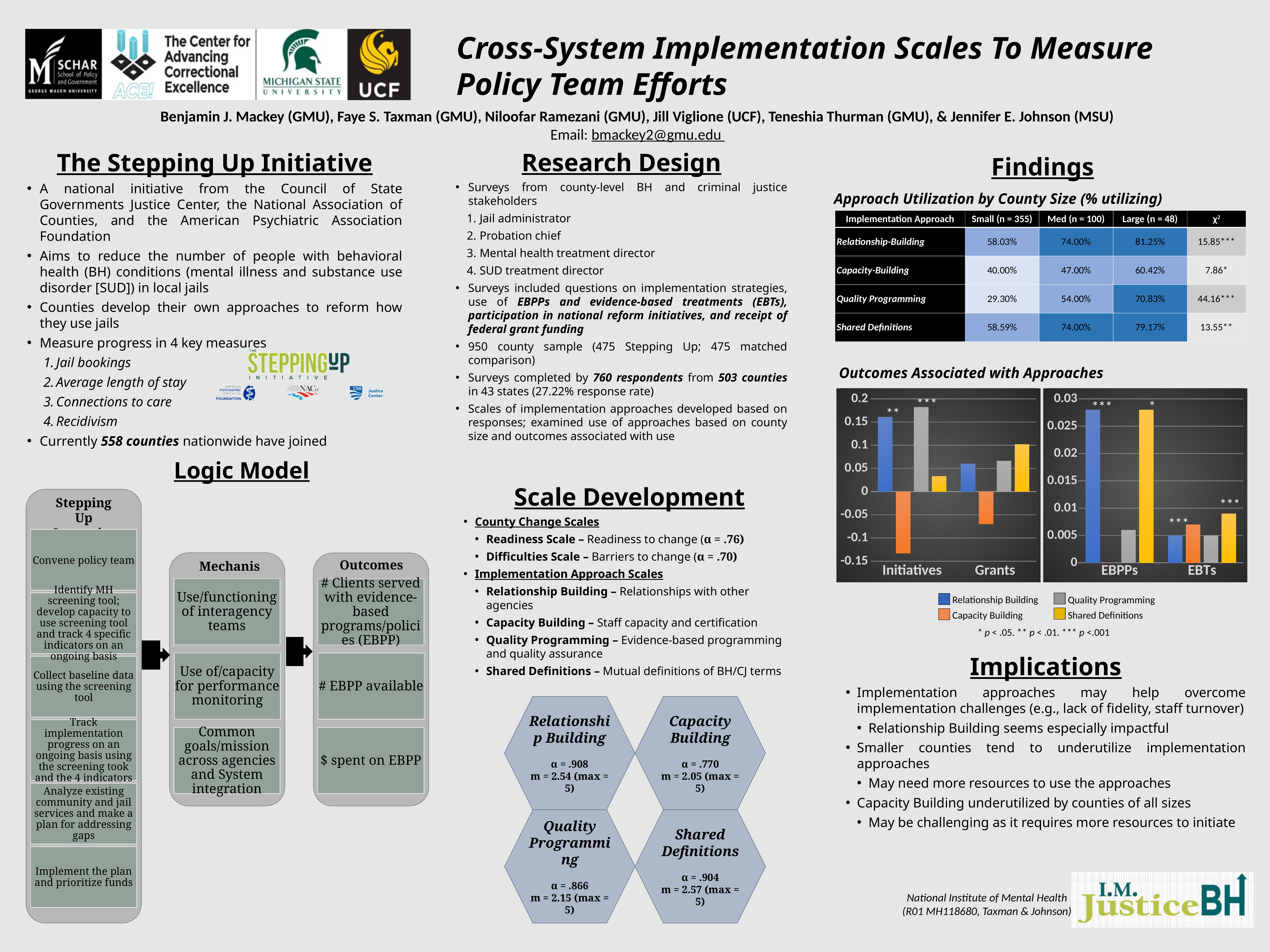
In the left 'Outcomes Associated with Approaches' chart, how many categories are shown on the x axis? 2 In the left 'Outcomes Associated with Approaches' chart, is the Shared Definitions value larger for Initiatives or for Grants? Grants How many series does the legend list for the 'Outcomes Associated with Approaches' charts? 4 In the left 'Outcomes Associated with Approaches' chart, is the Capacity Building value for Initiatives greater or less than -0.1? less In the right 'Outcomes Associated with Approaches' chart, is the Relationship Building value larger for EBPPs or for EBTs? EBPPs In the left 'Outcomes Associated with Approaches' chart, is the Relationship Building value for Initiatives greater or less than 0.1? greater What kind of chart is used in the 'Outcomes Associated with Approaches' section? bar chart In the 'Outcomes Associated with Approaches' charts, what colour represents Capacity Building? orange In the left 'Outcomes Associated with Approaches' chart, is the Shared Definitions value for Grants greater or less than 0.05? greater In the left 'Outcomes Associated with Approaches' chart, which series has the lowest value for Initiatives? Capacity Building